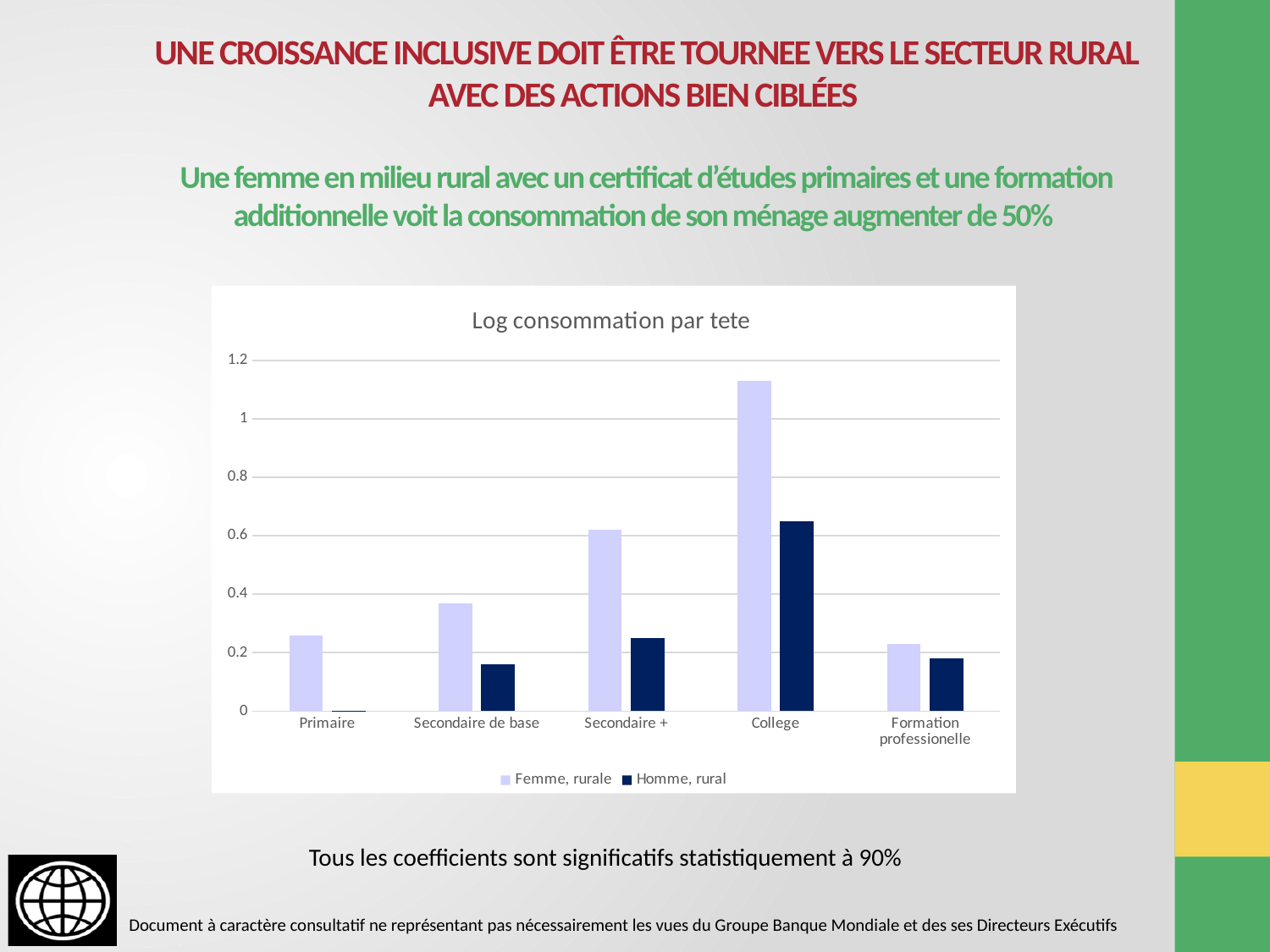
What is the title of the chart? Log consommation par tete For the College category, which series has the larger value, 'Femme, rurale' or 'Homme, rural'? Femme, rurale Is the 'Homme, rural' value for College greater or less than 0.8? less How many series does the chart legend list? 2 Which category has the lowest value for the 'Homme, rural' series? Primaire For the Secondaire + category, which series has the larger value, 'Femme, rurale' or 'Homme, rural'? Femme, rurale Which category has the highest value for the 'Homme, rural' series? College What kind of chart is shown on the slide? bar chart Is the 'Femme, rurale' value for College greater or less than 1? greater Which category has the highest value for the 'Femme, rurale' series? College How many education categories are shown on the x axis of the chart? 5 Is the 'Homme, rural' value for Secondaire de base greater or less than 0.2? less